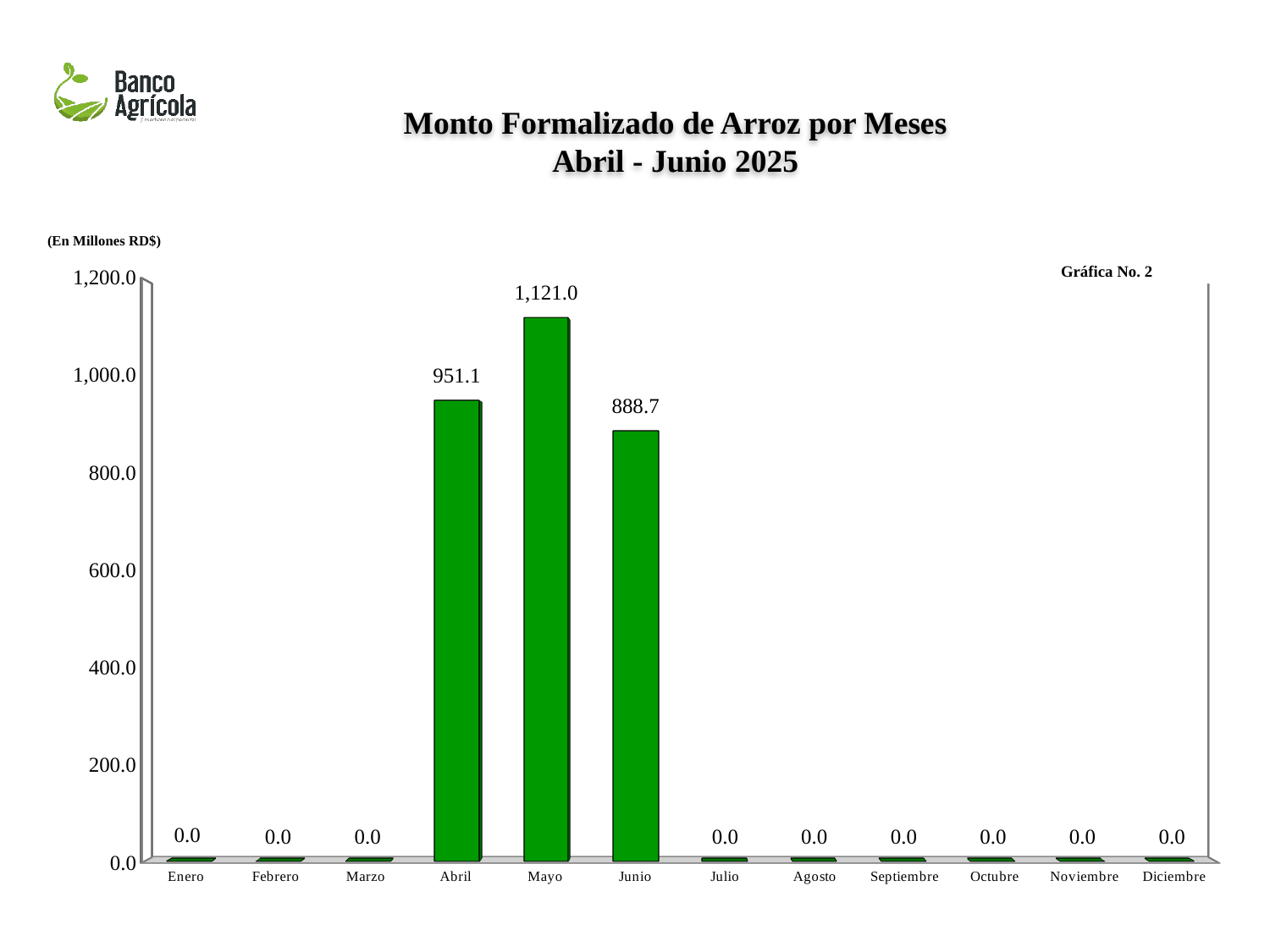
What is the value for Junio? 888.7 What is the difference between the values for Abril and Junio? 62.4 What is the difference between the values for Mayo and Abril? 169.9 What kind of chart is shown on the slide? bar chart What is the value for Enero? 0.0 What is the value for Mayo? 1,121.0 What unit is stated for the values in the chart? En Millones RD$ Which month has the highest value? Mayo How many months are shown on the x axis? 12 Is the value for Mayo greater or less than 1,000.0? greater Which is larger, the value for Abril or the value for Junio? Abril What is the value for Abril? 951.1